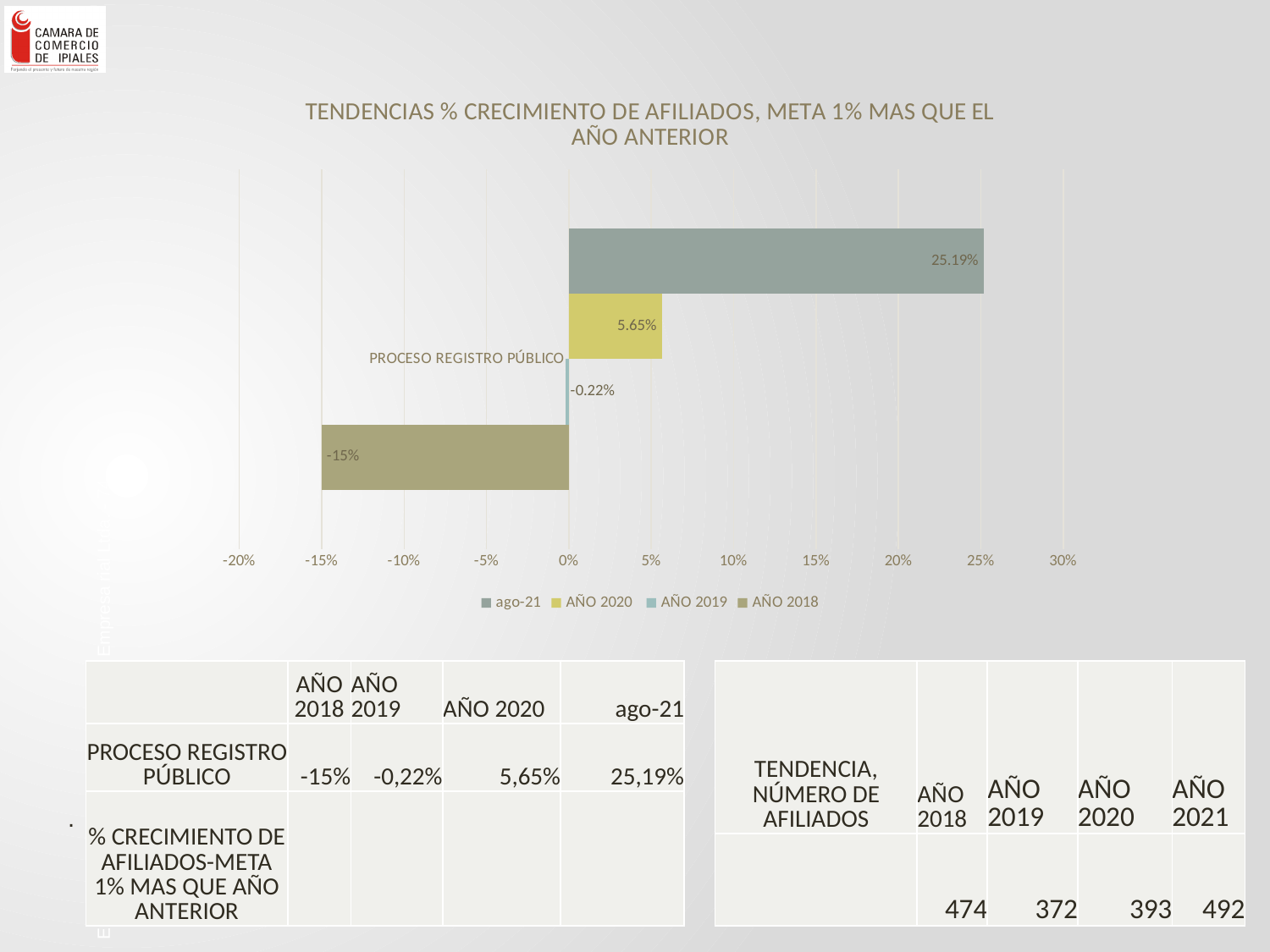
What is the value for the AÑO 2020 series in the chart? 5.65% What is the value for the ago-21 series in the chart? 25.19% What is the value for the AÑO 2018 series in the chart? -15% Which is larger, the value for AÑO 2020 or the value for AÑO 2019? AÑO 2020 What is the value for the AÑO 2019 series in the chart? -0.22% Which series has the lowest value in the chart? AÑO 2018 What kind of chart is shown on the slide? Bar chart What is the category label shown on the chart? PROCESO REGISTRO PÚBLICO How many series does the legend list? 4 Is the value for ago-21 greater or less than 20%? greater What is the difference between the ago-21 value and the AÑO 2020 value? 19.54% Which series has the highest value in the chart? ago-21